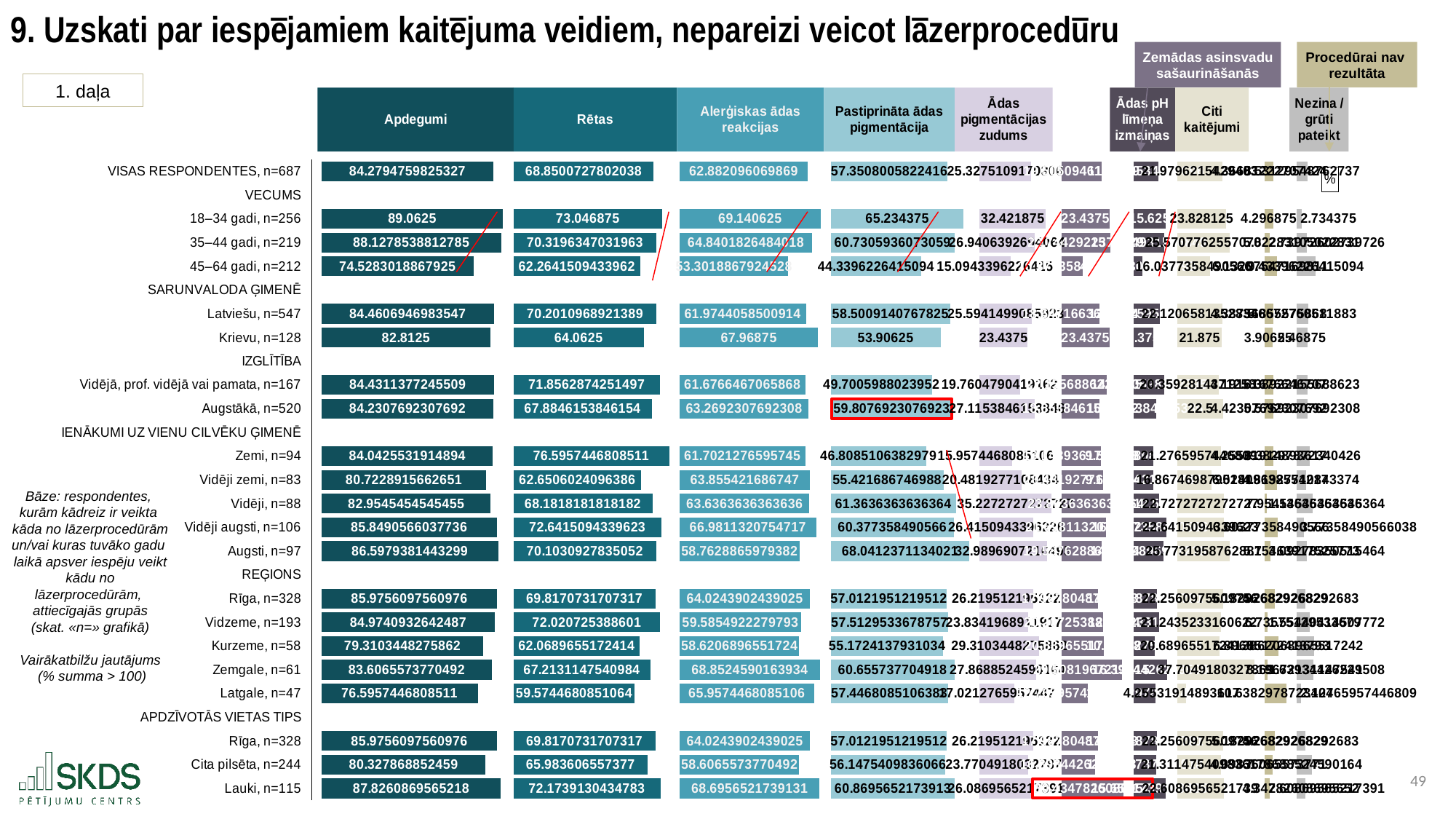
What is the Apdegumi value for VISAS RESPONDENTES, n=687? 84.2794759825327 What is the difference between the Apdegumi values for 18–34 gadi, n=256 and Krievu, n=128? 6.25 What is the Apdegumi value for the 18–34 gadi, n=256 group? 89.0625 What is the Alerģiskas ādas reakcijas value for the 18–34 gadi, n=256 group? 69.140625 Among the regions (REĢIONS), which has the lowest Apdegumi value? Latgale, n=47 Which group has the larger Rētas value: 18–34 gadi, n=256 or Krievu, n=128? 18–34 gadi, n=256 What is the difference between the Pastiprināta ādas pigmentācija values for 18–34 gadi, n=256 and Krievu, n=128? 11.328125 What kind of chart is shown on the slide? Bar chart What is the Rētas value for the Krievu, n=128 group? 64.0625 Among the age groups (VECUMS), which has the highest Apdegumi value? 18–34 gadi, n=256 What is the Pastiprināta ādas pigmentācija value for the Krievu, n=128 group? 53.90625